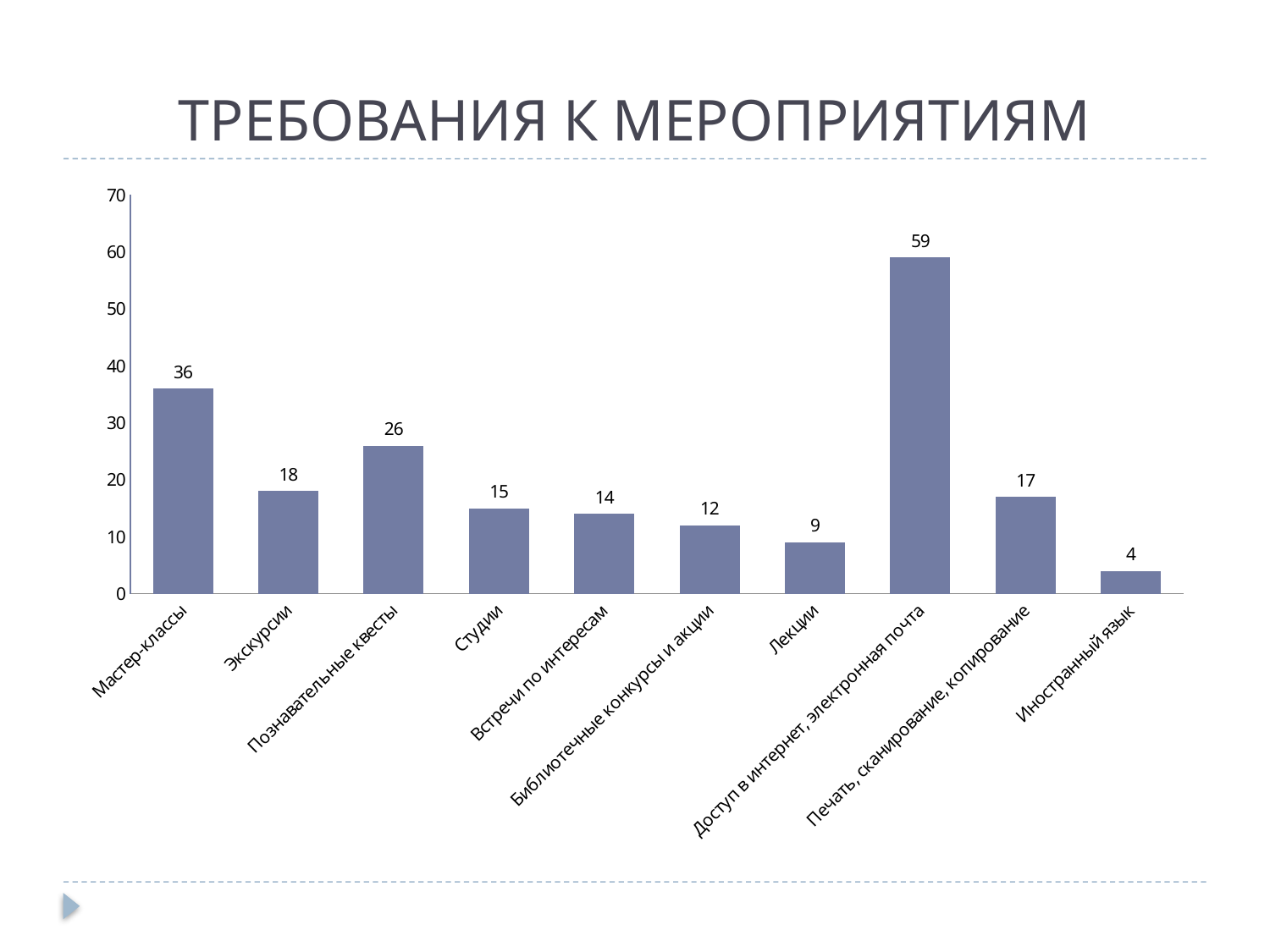
How many categories are shown on the x axis? 10 What is the value for Мастер-классы? 36 What is the value for Лекции? 9 Is the value for Студии greater or less than 20? less Which category has the lowest value? Иностранный язык What is the value for Иностранный язык? 4 What is the title of the slide? ТРЕБОВАНИЯ К МЕРОПРИЯТИЯМ Which category has the highest value? Доступ в интернет, электронная почта What kind of chart is shown on the slide? bar chart What is the value for Доступ в интернет, электронная почта? 59 Which is larger, the value for Познавательные квесты or the value for Печать, сканирование, копирование? Познавательные квесты What is the difference between the values for Мастер-классы and Экскурсии? 18